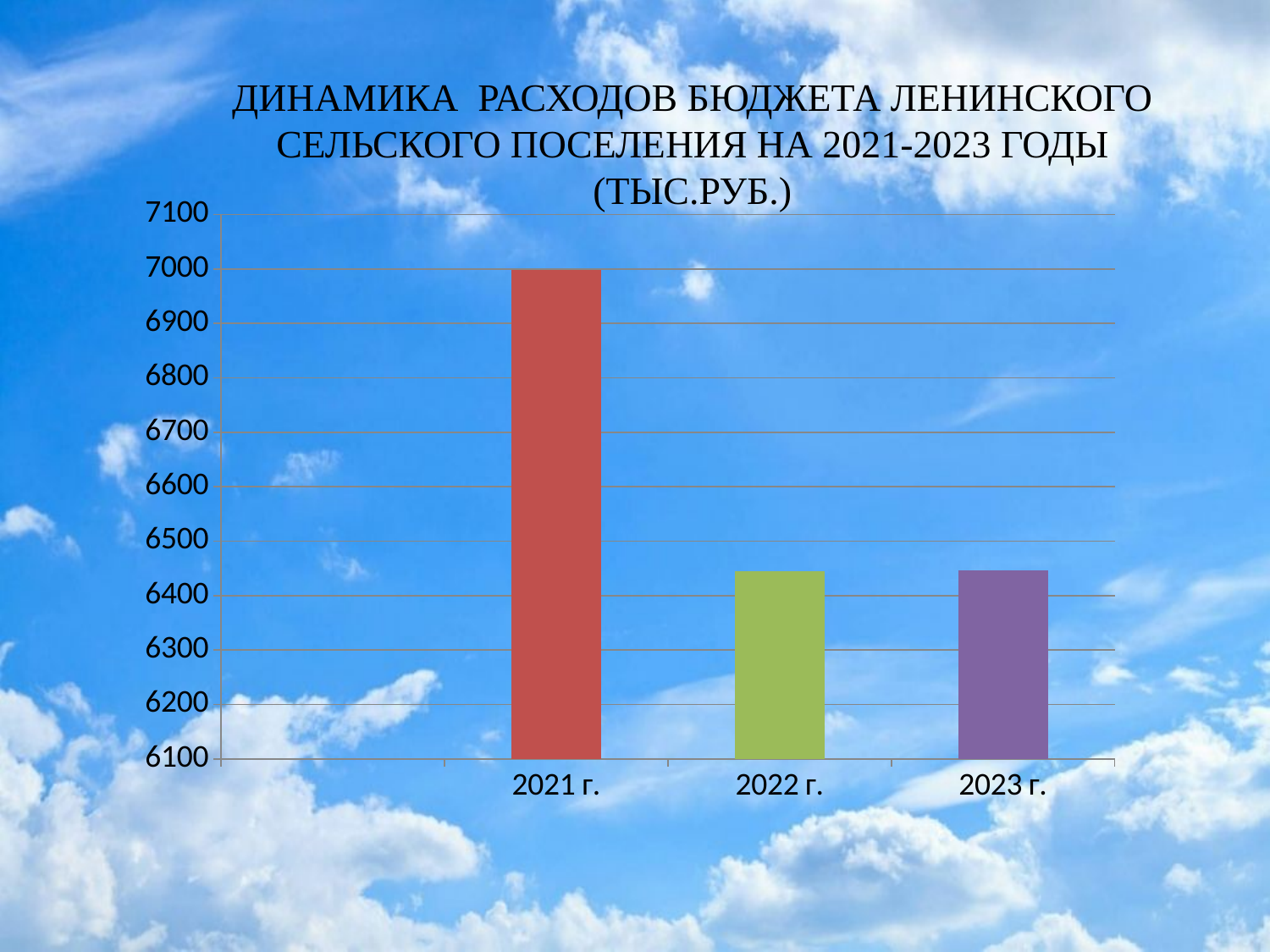
Is the value for 2023 г. greater or less than 6500? less What kind of chart is shown on the slide? bar chart Do the values rise or fall from 2021 г. to 2022 г.? fall How many years (categories) are plotted on the chart? 3 Is the value for 2023 г. greater or less than 6400? greater Is the value for 2022 г. greater or less than 6400? greater What colour is the bar for 2021 г.? red Which year has the highest budget expenditure on the chart? 2021 г. Which is larger, the value for 2021 г. or the value for 2022 г.? 2021 г.